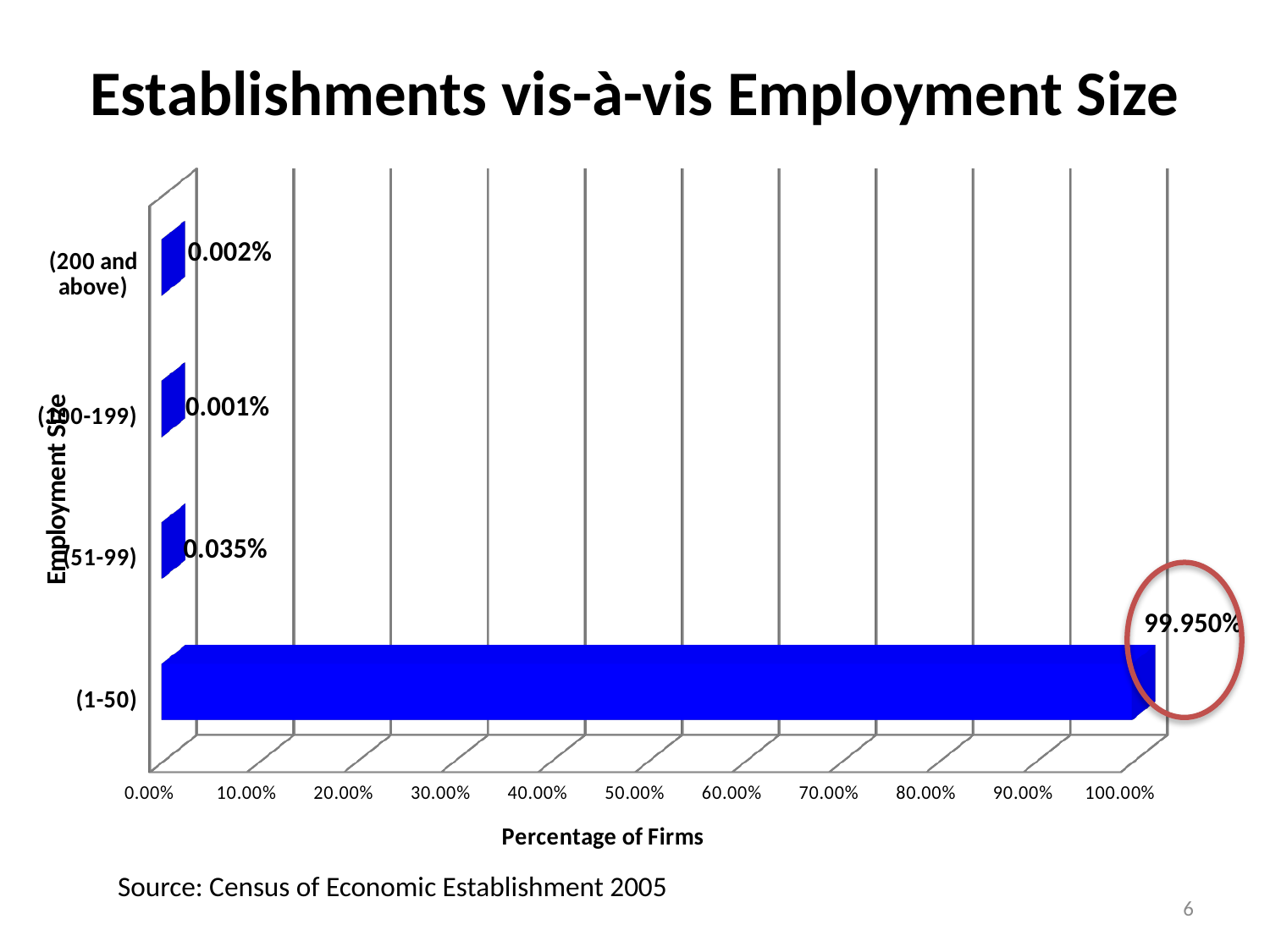
What is the difference between the percentage for (51-99) and the percentage for (200 and above)? 0.033% What is the title of the horizontal axis of the chart? Percentage of Firms How many employment size categories are plotted on the chart? 4 What percentage of firms is shown for the (51-99) employment size category? 0.035% What percentage of firms is shown for the (200 and above) employment size category? 0.002% Is the value for the (1-50) category greater or less than 90.00%? greater Which has a larger percentage of firms, (51-99) or (200 and above)? (51-99) What percentage of firms is shown for the (1-50) employment size category? 99.950% What is the lowest percentage value labelled on the chart? 0.001% What is the title of the vertical axis of the chart? Employment Size What kind of chart is shown on the slide? bar chart Which employment size category has the highest percentage of firms? (1-50)